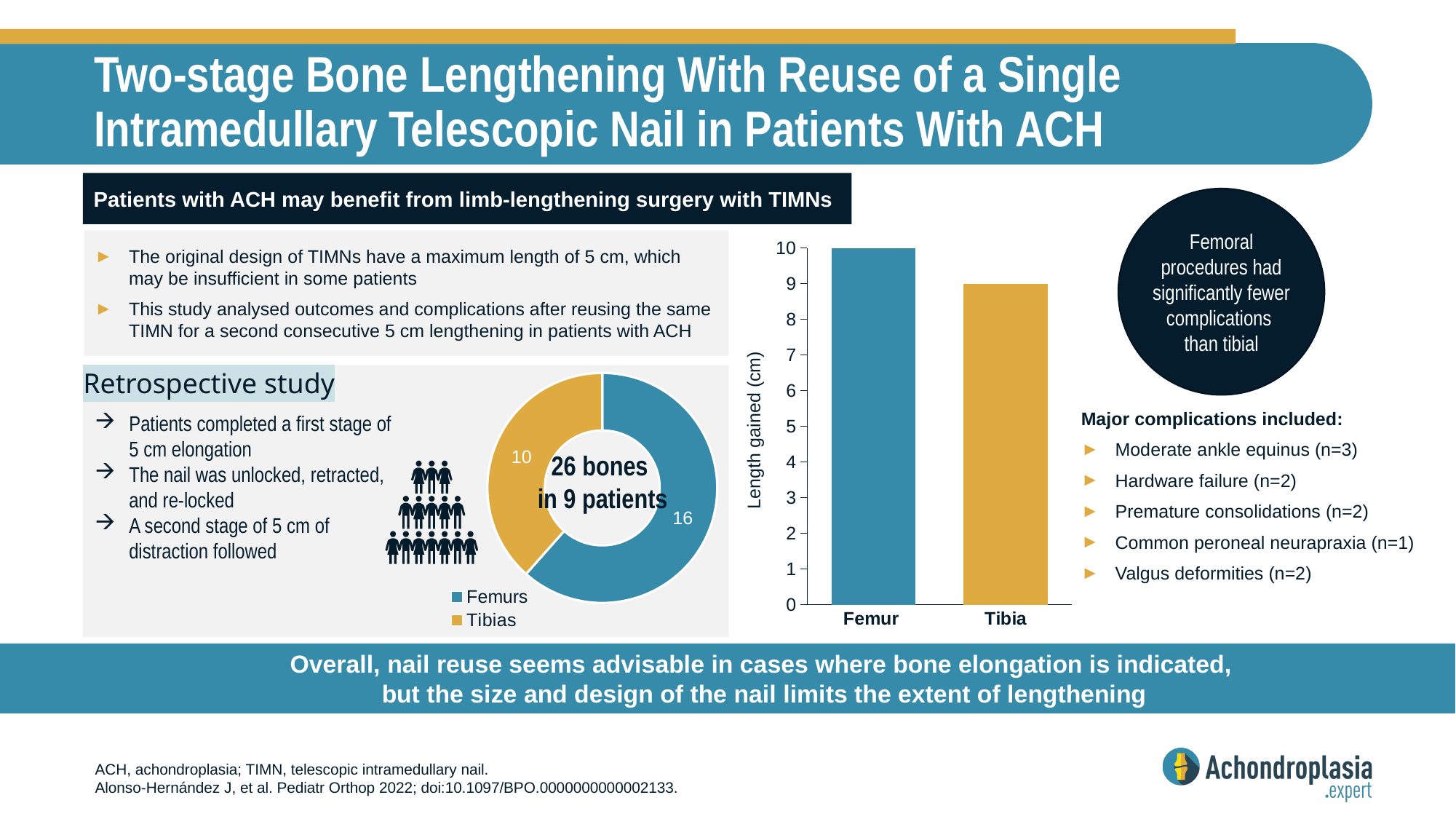
In the donut chart, what is the difference between the number of femurs and the number of tibias? 6 In the bar chart on the right, which bone has the greater length gained? Femur What type of chart is the chart on the right showing length gained? Bar chart In the donut chart, which category has the larger count, Femurs or Tibias? Femurs In the donut chart, which colour represents Tibias? Gold/yellow In the bar chart on the right, what is the length gained for Femur? 10 In the donut chart, how many tibias were included? 10 In the bar chart on the right, what is the label of the vertical axis? Length gained (cm) In the donut chart, what is the total number of bones shown? 26 How many entries does the legend of the donut chart list? 2 In the donut chart, how many femurs were included? 16 In the bar chart on the right, what is the length gained for Tibia? 9